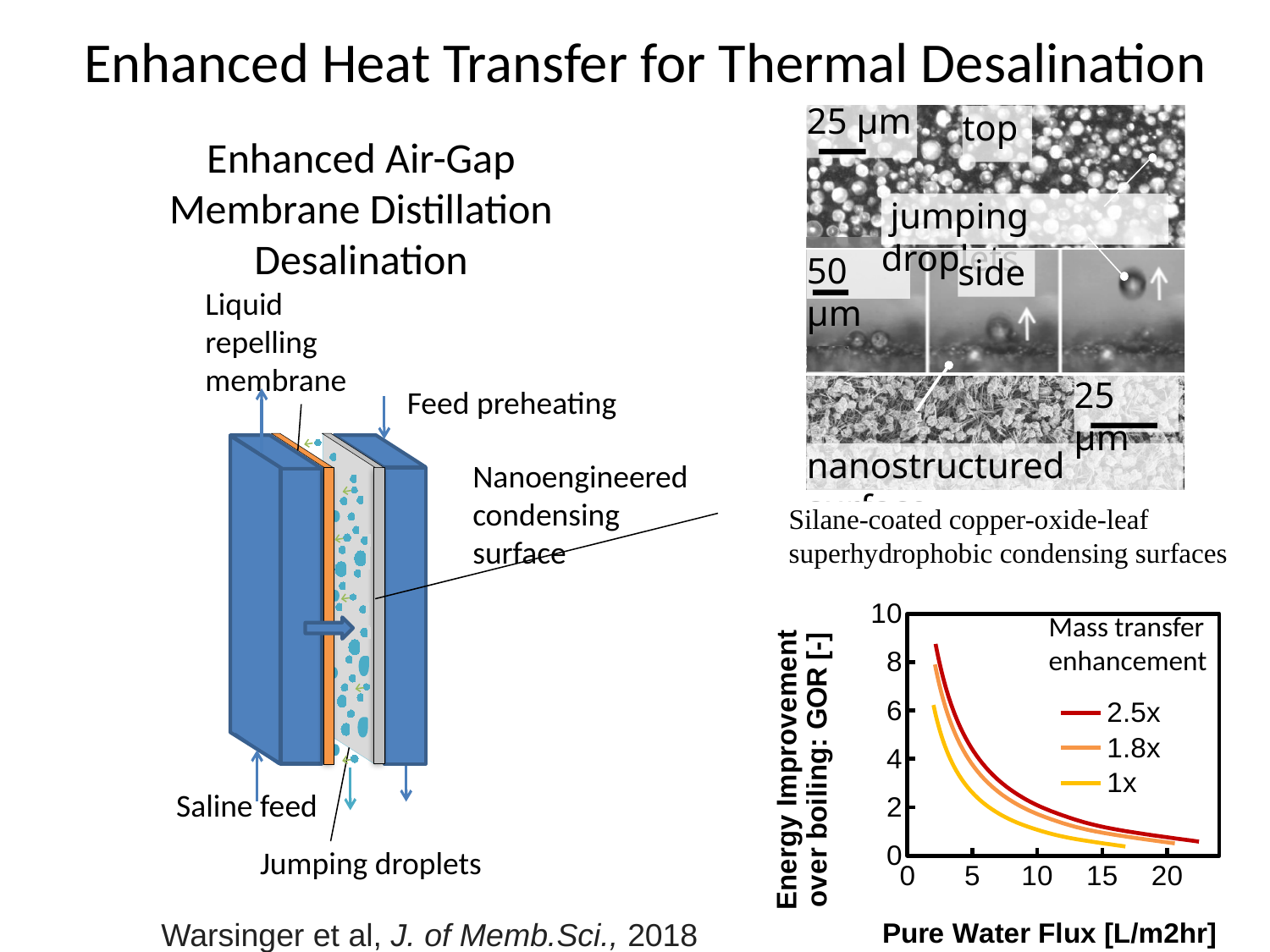
Is the value for the 1x series at a Pure Water Flux of 15 L/m2hr greater or less than 2? less What are the three series named in the chart legend? 2.5x, 1.8x, 1x Is the highest value of the 2.5x series in the chart greater or less than 6? greater Which series in the chart has the lowest Energy Improvement at any given Pure Water Flux? 1x How many series does the legend of the chart list? 3 Do the curves in the chart rise or fall as Pure Water Flux increases? fall Which series in the chart has the highest Energy Improvement at any given Pure Water Flux? 2.5x What is the maximum value shown on the chart's y axis? 10 Is the value for the 2.5x series at a Pure Water Flux of 20 L/m2hr greater or less than 2? less What kind of chart is shown at the bottom right of the slide? line chart At a Pure Water Flux of 10 L/m2hr, is the value for the 2.5x series larger or smaller than the value for the 1x series? larger What is the title of the chart's x axis? Pure Water Flux [L/m2hr]